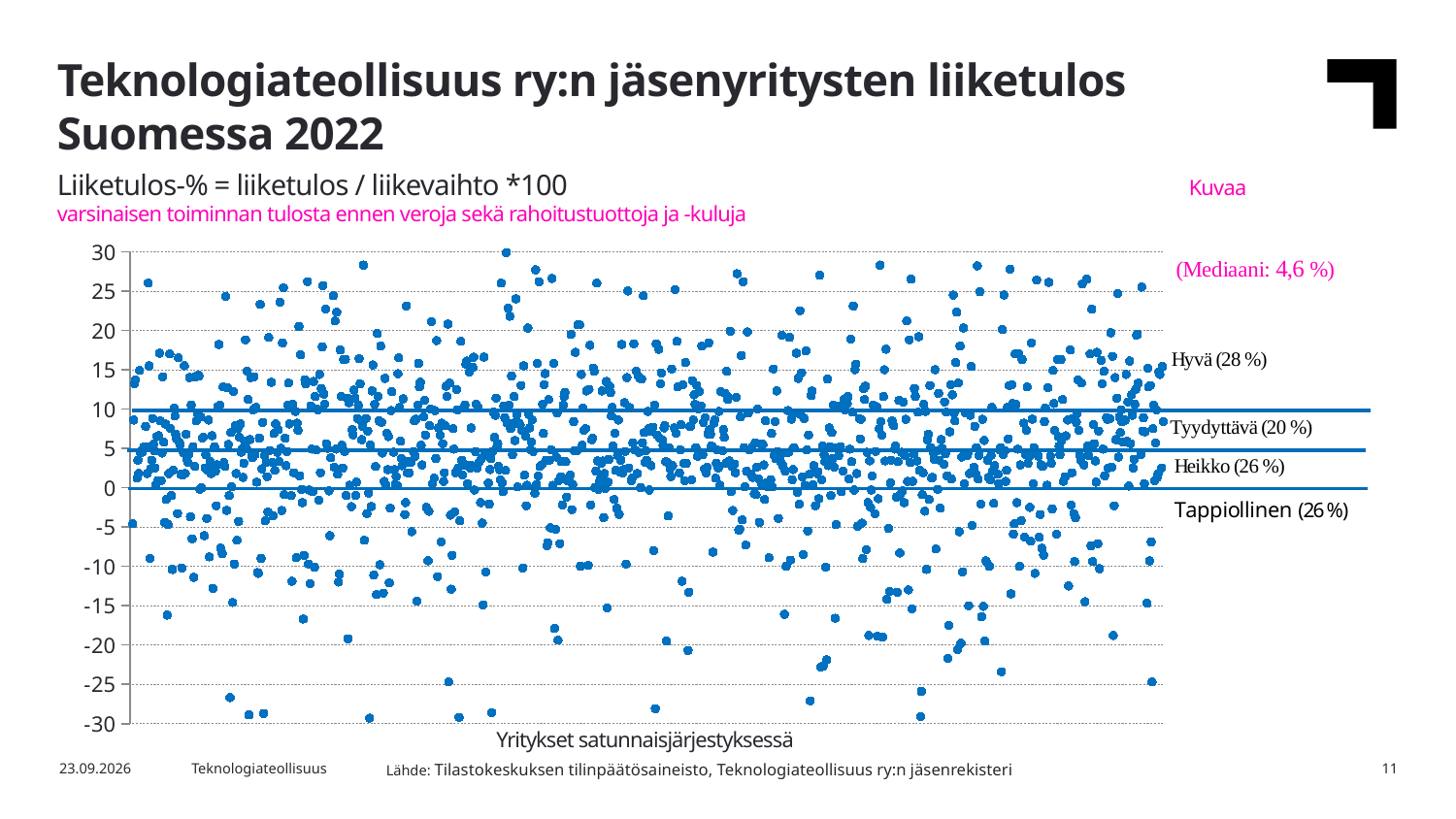
What is the median operating profit percentage (Mediaani) shown on the chart? 4,6 % What share of companies falls into the 'Tyydyttävä' category according to the chart? 20 % What share of companies falls into the 'Tappiollinen' category according to the chart? 26 % What kind of chart is shown on the slide? Scatter chart Which category has the largest share of companies: Hyvä, Tyydyttävä, Heikko or Tappiollinen? Hyvä (28 %) What share of companies falls into the 'Hyvä' category according to the chart? 28 % What is the difference in percentage points between the Hyvä share and the Tyydyttävä share? 8 percentage points Which category has the smallest share of companies: Hyvä, Tyydyttävä, Heikko or Tappiollinen? Tyydyttävä (20 %) What is the label of the x axis of the chart? Yritykset satunnaisjärjestyksessä What share of companies falls into the 'Heikko' category according to the chart? 26 % Is the median value shown on the chart greater or less than 5? less Which category has a larger share of companies, Hyvä or Tyydyttävä? Hyvä